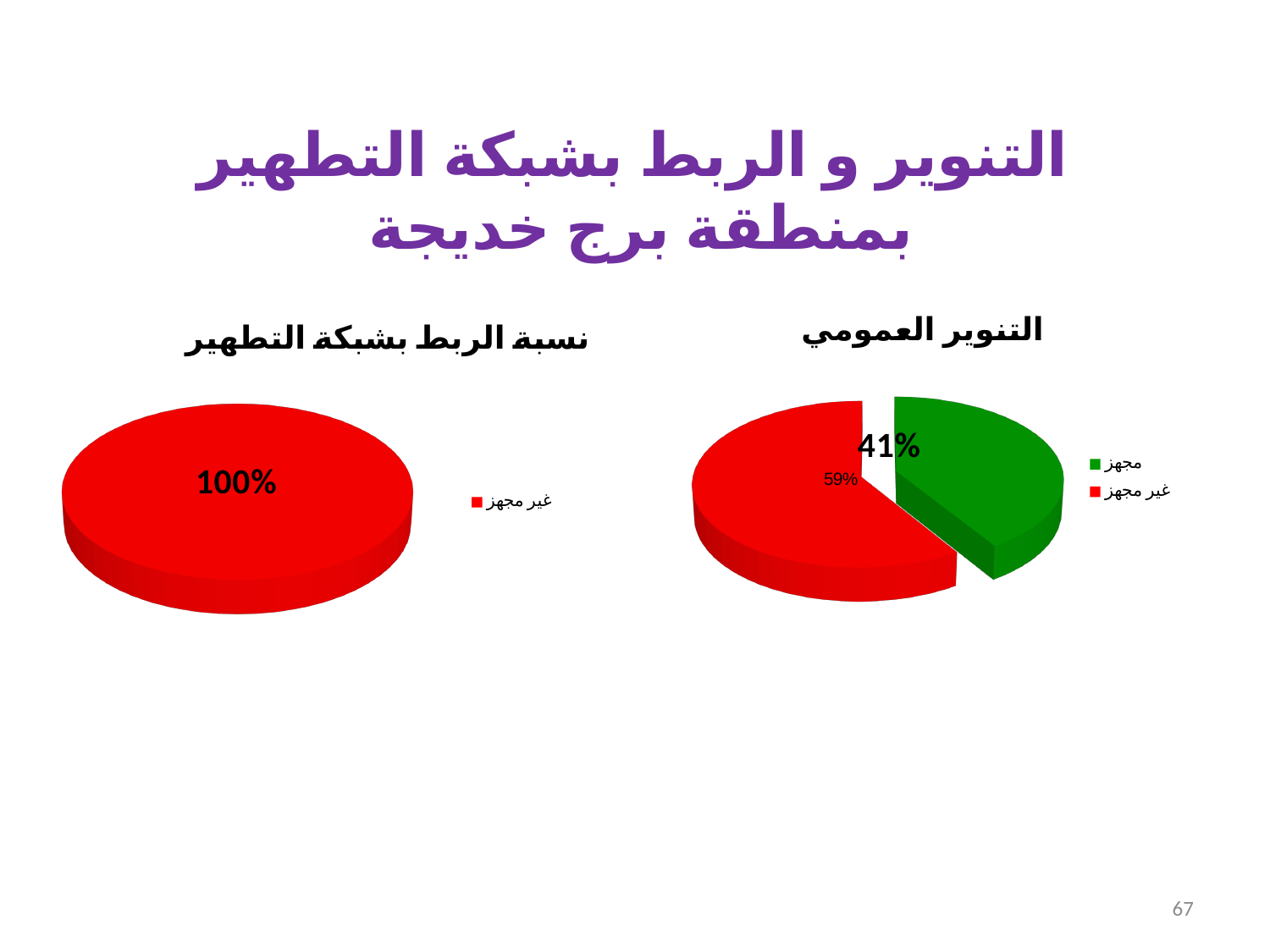
In the chart titled "التنوير العمومي", what share of the pie is labelled "مجهز"? 41% In the chart titled "التنوير العمومي", which category has the smaller share? مجهز What kind of chart is the chart titled "نسبة الربط بشبكة التطهير"? Pie chart How many charts are shown on the slide? 2 What kind of chart is the chart titled "التنوير العمومي"? Pie chart In the chart titled "نسبة الربط بشبكة التطهير", what share of the pie is labelled "غير مجهز"? 100% In the chart titled "التنوير العمومي", what is the difference in percentage points between "غير مجهز" and "مجهز"? 18 In the chart titled "نسبة الربط بشبكة التطهير", how many categories does the legend list? 1 In the chart titled "التنوير العمومي", what colour is the "مجهز" slice? Green In the chart titled "التنوير العمومي", what share of the pie is labelled "غير مجهز"? 59% In the chart titled "التنوير العمومي", which category has the larger share? غير مجهز In the chart titled "التنوير العمومي", how many categories does the legend list? 2